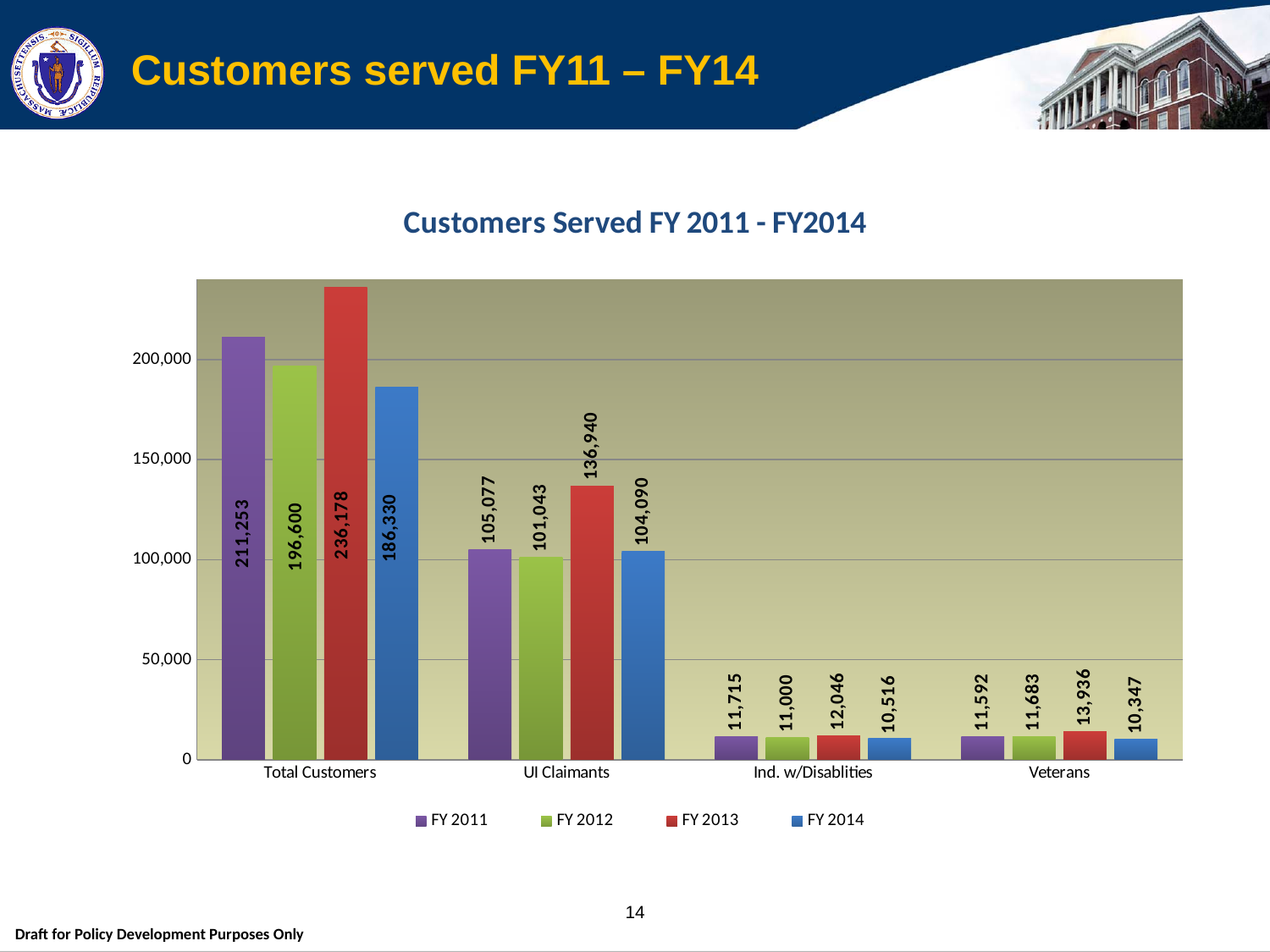
Which is larger, the FY 2011 value for Veterans or the FY 2012 value for Veterans? FY 2012 How many categories are shown on the x axis? 4 What is the value for UI Claimants in FY 2012? 101,043 What is the value for Veterans in FY 2014? 10,347 Is the value for UI Claimants in FY 2013 greater or less than 100,000? greater What is the title of the chart? Customers Served FY 2011 - FY2014 Which fiscal year has the lowest value for Total Customers? FY 2014 What is the difference between the FY 2013 and FY 2014 values for Total Customers? 49,848 Which fiscal year has the highest value for Ind. w/Disablities? FY 2013 What is the value for Total Customers in FY 2013? 236,178 What kind of chart is shown on the slide? bar chart How many series does the legend list? 4